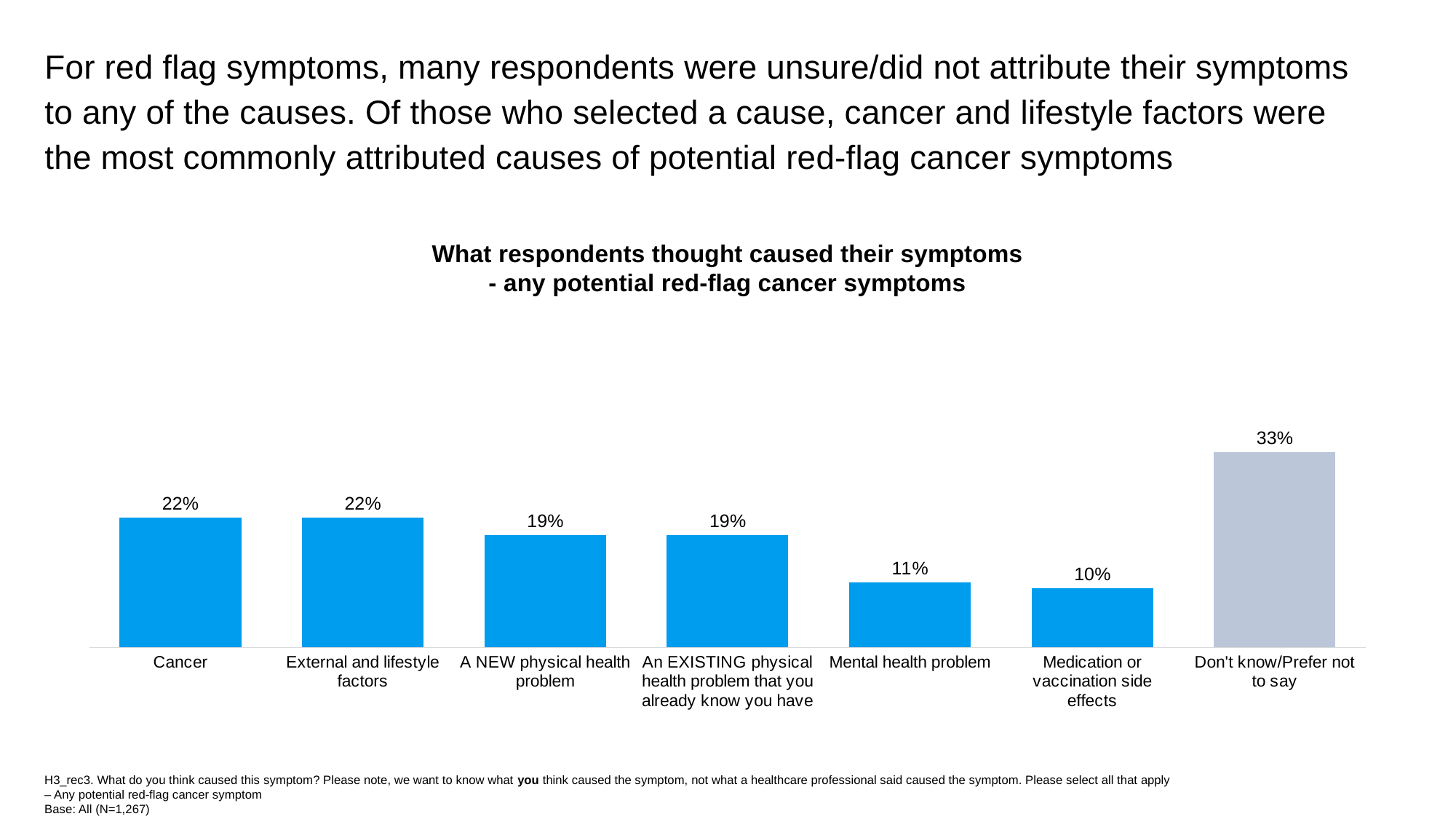
What is the value for Mental health problem? 11% How many categories are shown in the chart? 7 What is the value for Don't know/Prefer not to say? 33% What is the value for Medication or vaccination side effects? 10% What type of chart is shown on the slide? Bar chart What is the difference between A NEW physical health problem and Mental health problem? 8 percentage points Which category has the lowest value? Medication or vaccination side effects Which bar is shown in a different colour (grey) from the others? Don't know/Prefer not to say Which category has the highest value? Don't know/Prefer not to say Which is larger: External and lifestyle factors or An EXISTING physical health problem that you already know you have? External and lifestyle factors What is the difference between Don't know/Prefer not to say and Cancer? 11 percentage points What percentage of respondents attributed their symptoms to Cancer? 22%